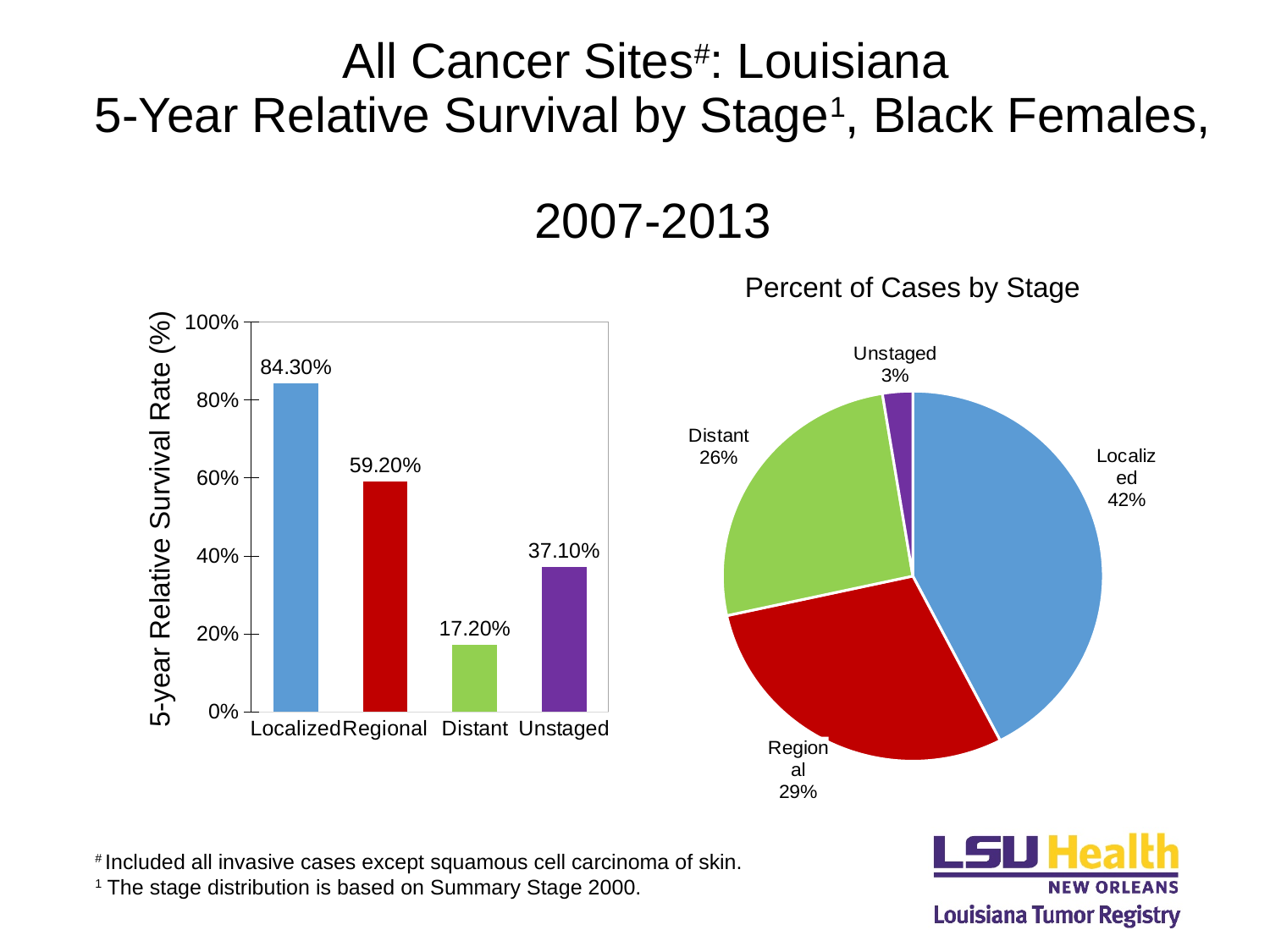
In the bar chart on the left, what is the 5-year relative survival rate for Localized stage? 84.30% In the 'Percent of Cases by Stage' chart, which stage has the largest share of cases? Localized In the 'Percent of Cases by Stage' chart, what share of cases are Localized? 42% In the bar chart on the left, how many stage categories are shown? 4 What kind of chart is the chart on the left? Bar chart In the bar chart on the left, what is the difference between the survival rates for Localized and Regional stages? 25.10% In the 'Percent of Cases by Stage' chart, what share of cases are Unstaged? 3% In the bar chart on the left, which stage has the highest 5-year relative survival rate? Localized In the bar chart on the left, which has a higher survival rate, Regional or Unstaged? Regional In the bar chart on the left, what is the 5-year relative survival rate for Distant stage? 17.20% What kind of chart is the 'Percent of Cases by Stage' chart? Pie chart In the bar chart on the left, which stage has the lowest 5-year relative survival rate? Distant